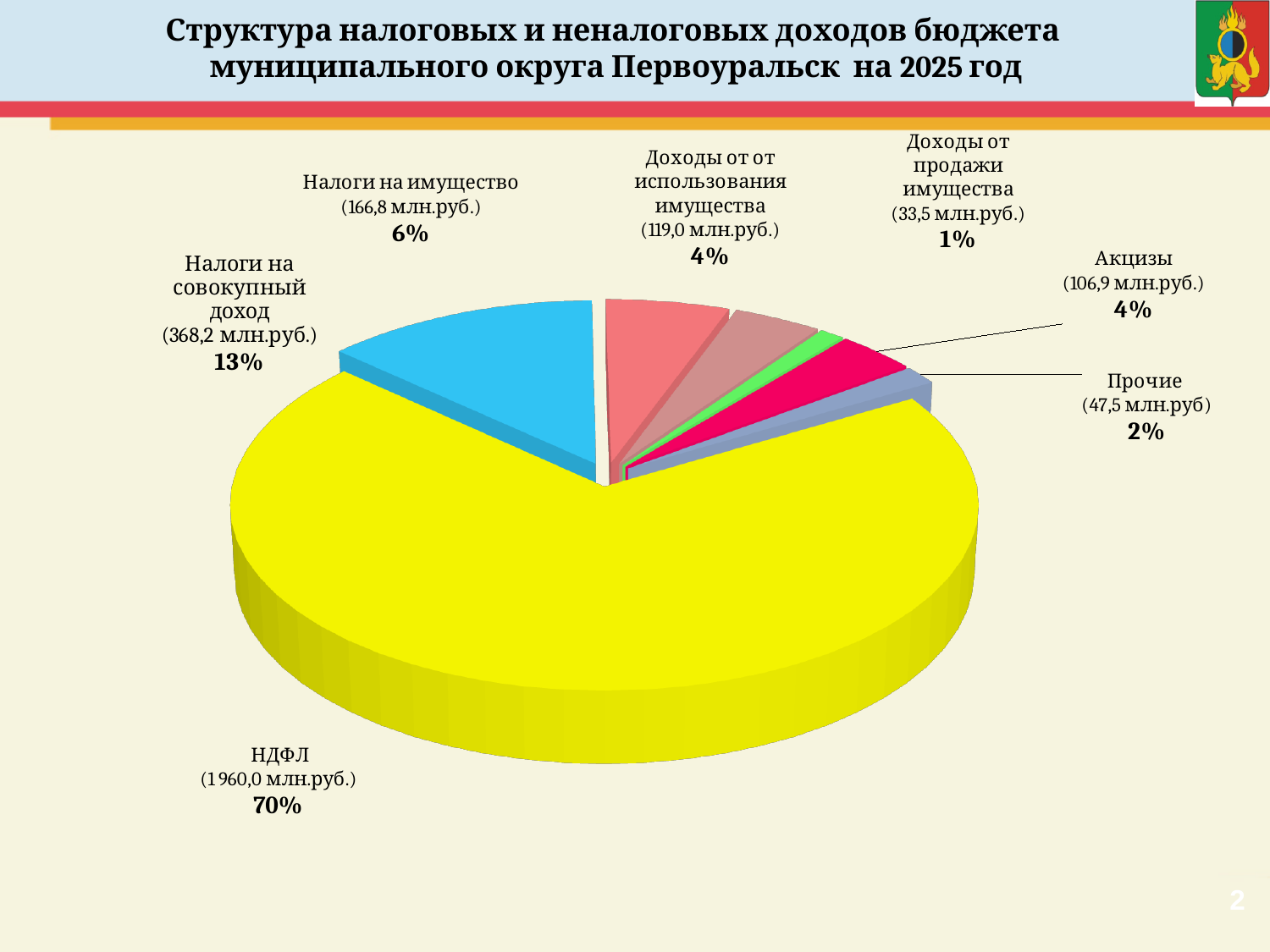
What share of the pie does Налоги на имущество represent? 6% What is the value shown for Налоги на совокупный доход? 368,2 млн.руб. Which is larger, Налоги на имущество or Доходы от использования имущества? Налоги на имущество How many slices does the pie chart have? 7 What is the value shown for Акцизы? 106,9 млн.руб. Which category has the smallest slice of the pie? Доходы от продажи имущества For which year does the chart show the structure of tax and non-tax budget revenues? 2025 What is the value shown for НДФЛ? 1960,0 млн.руб. What kind of chart is shown on the slide? pie chart What share of the pie does Прочие represent? 2% What is the difference in млн.руб. between Налоги на совокупный доход and Налоги на имущество? 201,4 млн.руб. Which category has the largest slice of the pie? НДФЛ